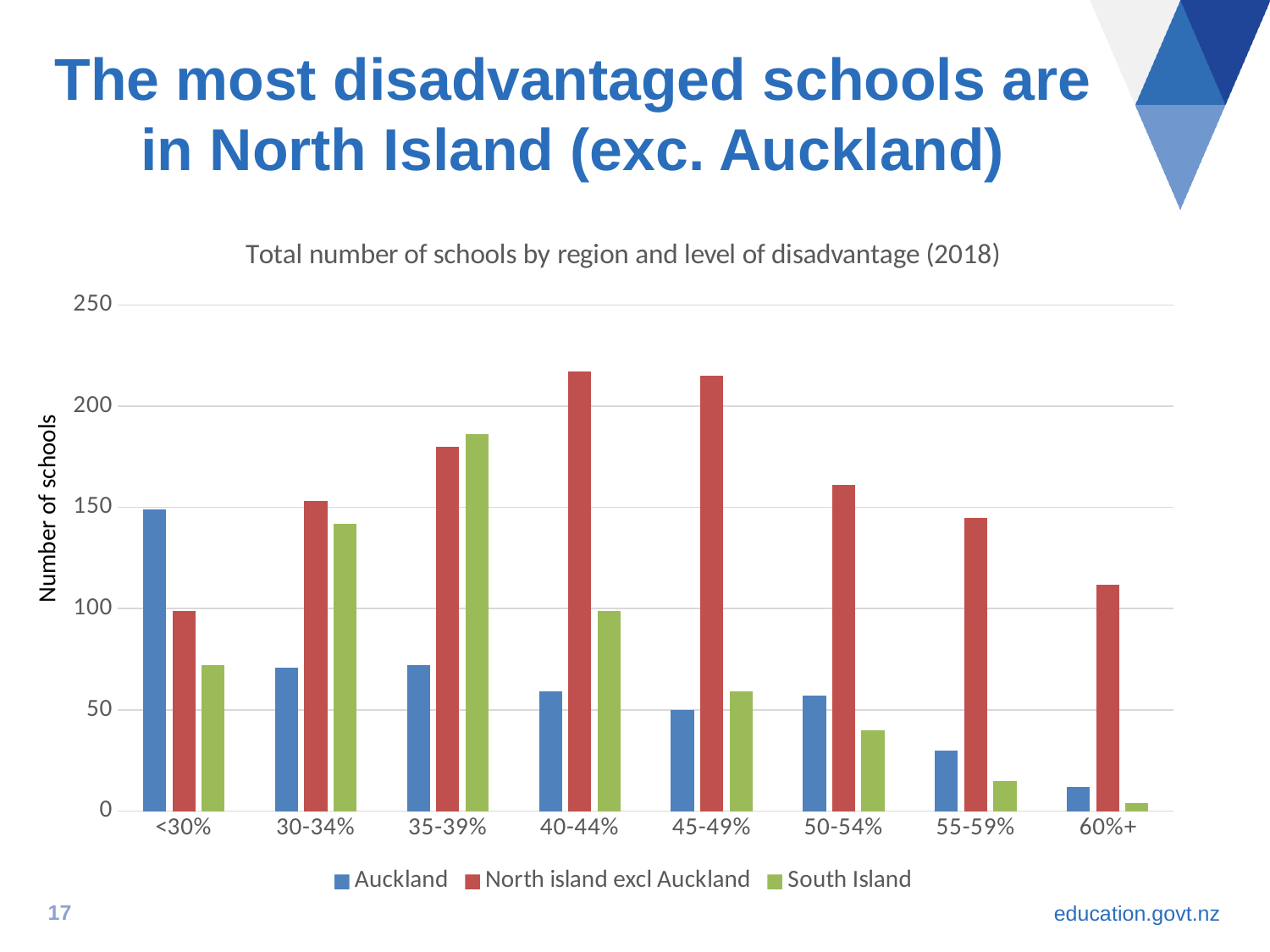
What kind of chart is shown on the slide? bar chart Which series is shown in red? North island excl Auckland Is the value for Auckland at 55-59% greater or less than 50? less In the <30% category, which is larger: Auckland or North island excl Auckland? Auckland How many disadvantage-level categories are shown on the x axis? 8 What is the title of the chart? Total number of schools by region and level of disadvantage (2018) Do the Auckland values generally rise or fall as the level of disadvantage increases along the x axis? fall How many series does the legend list? 3 For which disadvantage level is the Auckland value highest? <30% For which disadvantage level is the South Island value highest? 35-39% For which disadvantage level is the South Island value lowest? 60%+ Is the value for North island excl Auckland at 40-44% greater or less than 200? greater